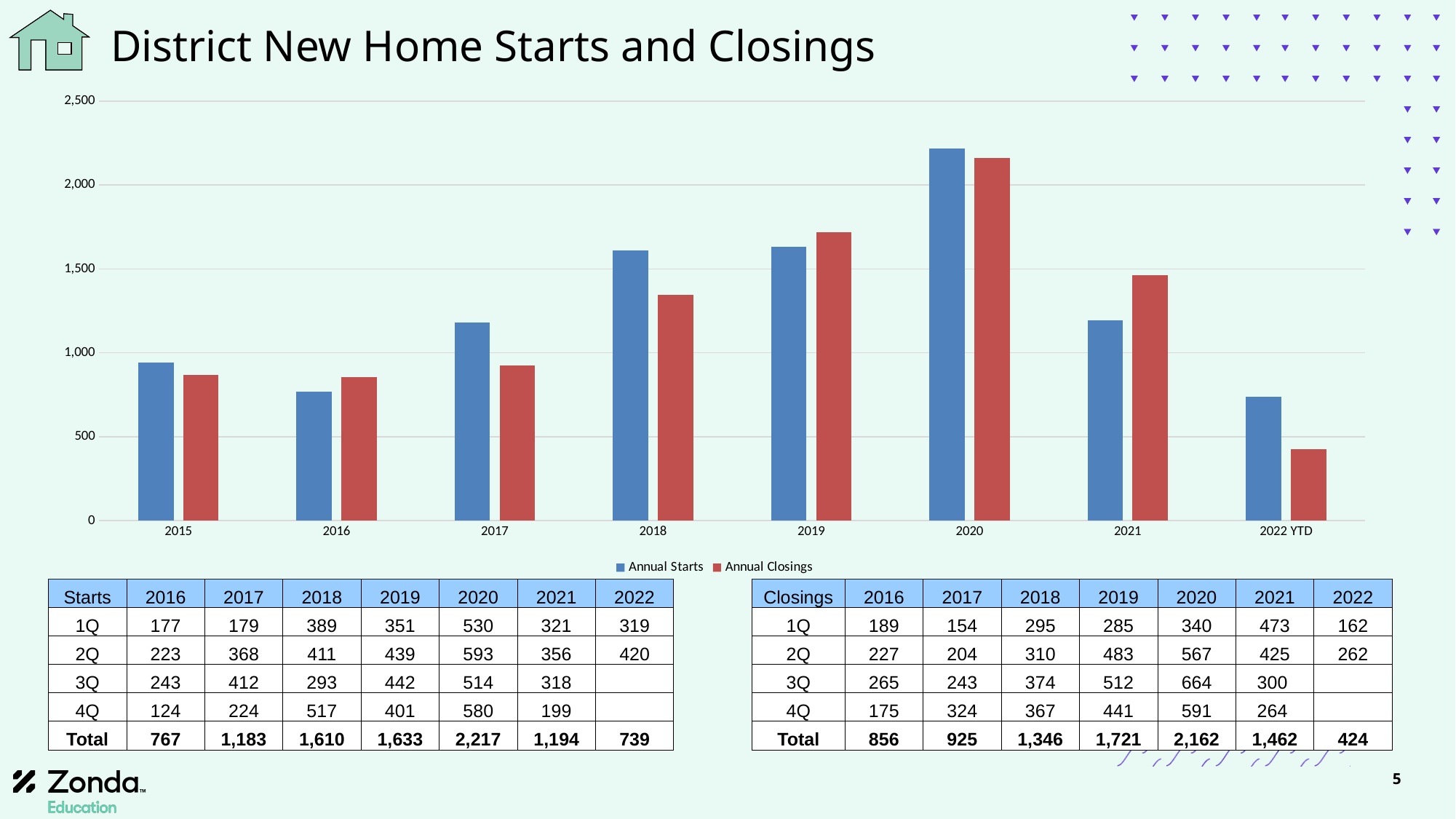
By how much do the 2020 Annual Starts (2,217) exceed the 2020 Annual Closings (2,162)? 55 What is the total of Annual Closings for 2019, as shown in the Closings table? 1,721 In which year are Annual Starts highest? 2020 In 2019, which is larger: Annual Starts or Annual Closings? Annual Closings How many series does the chart legend list? 2 What kind of chart is shown on the slide? bar chart How many year categories are shown along the x axis of the chart? 8 Between 2016 and 2020, do Annual Starts rise or fall? rise Which colour represents Annual Closings in the chart? red Is the value for Annual Starts in 2015 greater or less than 1,000? less In which year are Annual Closings lowest? 2022 YTD What is the total of Annual Starts for 2020, as shown in the Starts table? 2,217